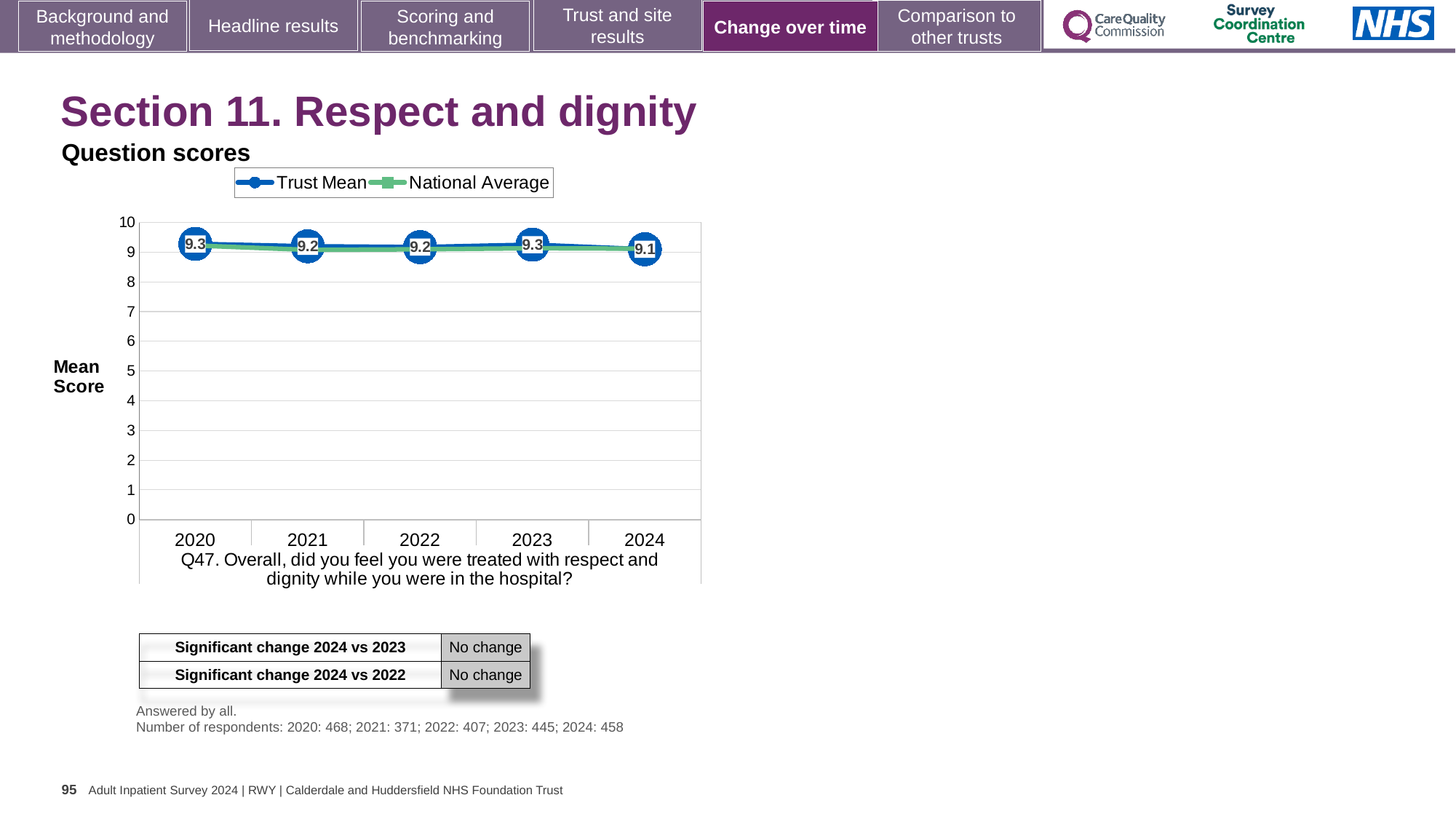
How many years are plotted on the x axis? 5 What is the Trust Mean score for 2020? 9.3 Which year has the lowest Trust Mean score? 2024 What kind of chart is shown on the slide? Line chart What is the label of the y axis? Mean Score Is the National Average value for 2024 greater or less than 8? greater What is the Trust Mean score for 2024? 9.1 What is the difference between the Trust Mean score in 2020 and in 2024? 0.2 How many series does the legend list? 2 What is the Trust Mean score for 2022? 9.2 Is the Trust Mean score higher in 2023 or in 2024? 2023 Does the Trust Mean score rise or fall from 2020 to 2024? Fall